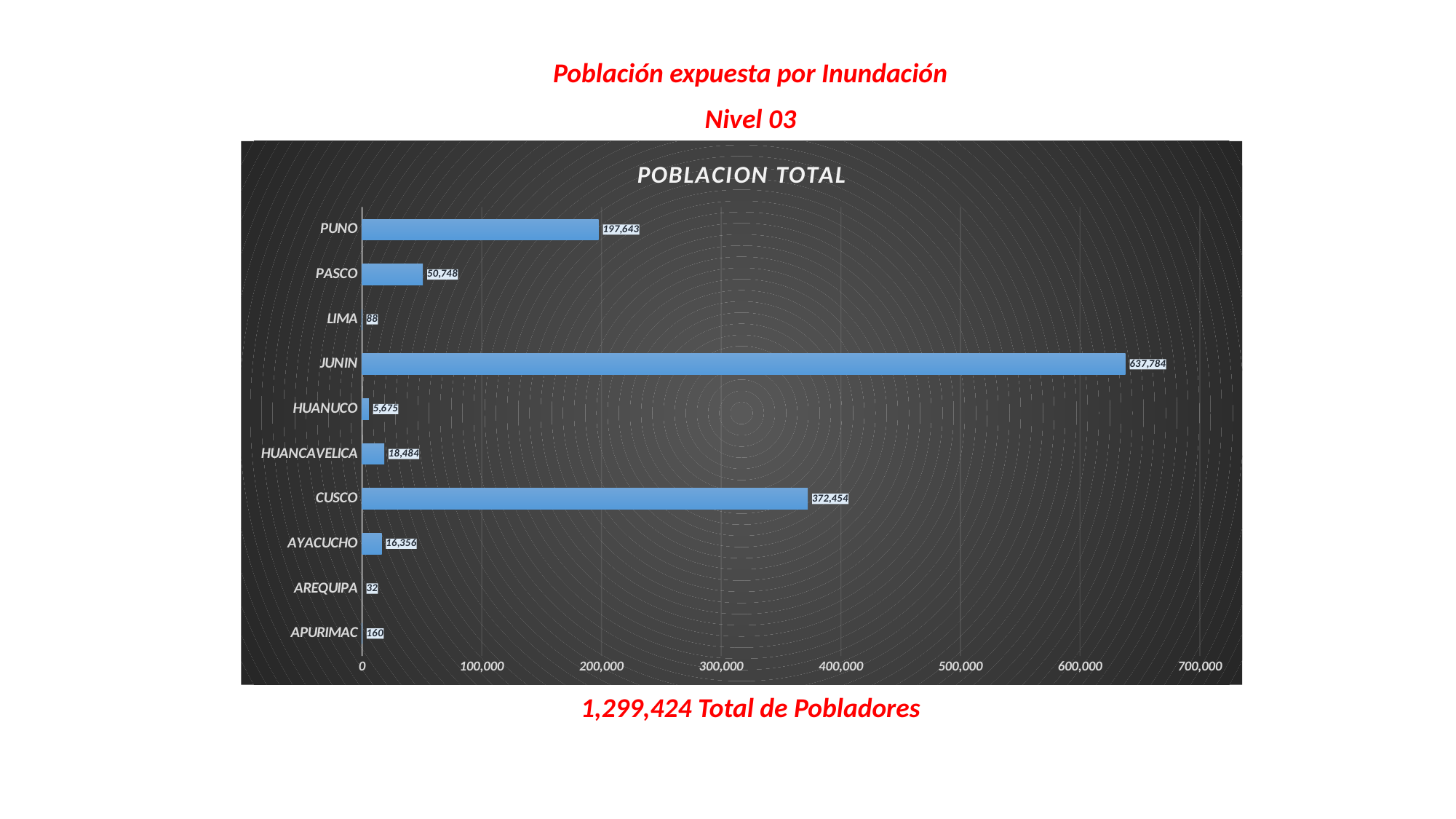
What is the value for JUNIN? 637,784 What is the value for CUSCO? 372,454 How many categories are shown in the chart? 10 What is the difference between the values for JUNIN and CUSCO? 265,330 Which is larger, the value for PASCO or the value for AYACUCHO? PASCO What is the title of the chart? POBLACION TOTAL What is the value for PUNO? 197,643 Is the value for CUSCO greater or less than 300,000? greater What kind of chart is shown? bar chart Which category has the lowest value? AREQUIPA What is the value for HUANCAVELICA? 18,484 Which category has the highest value? JUNIN